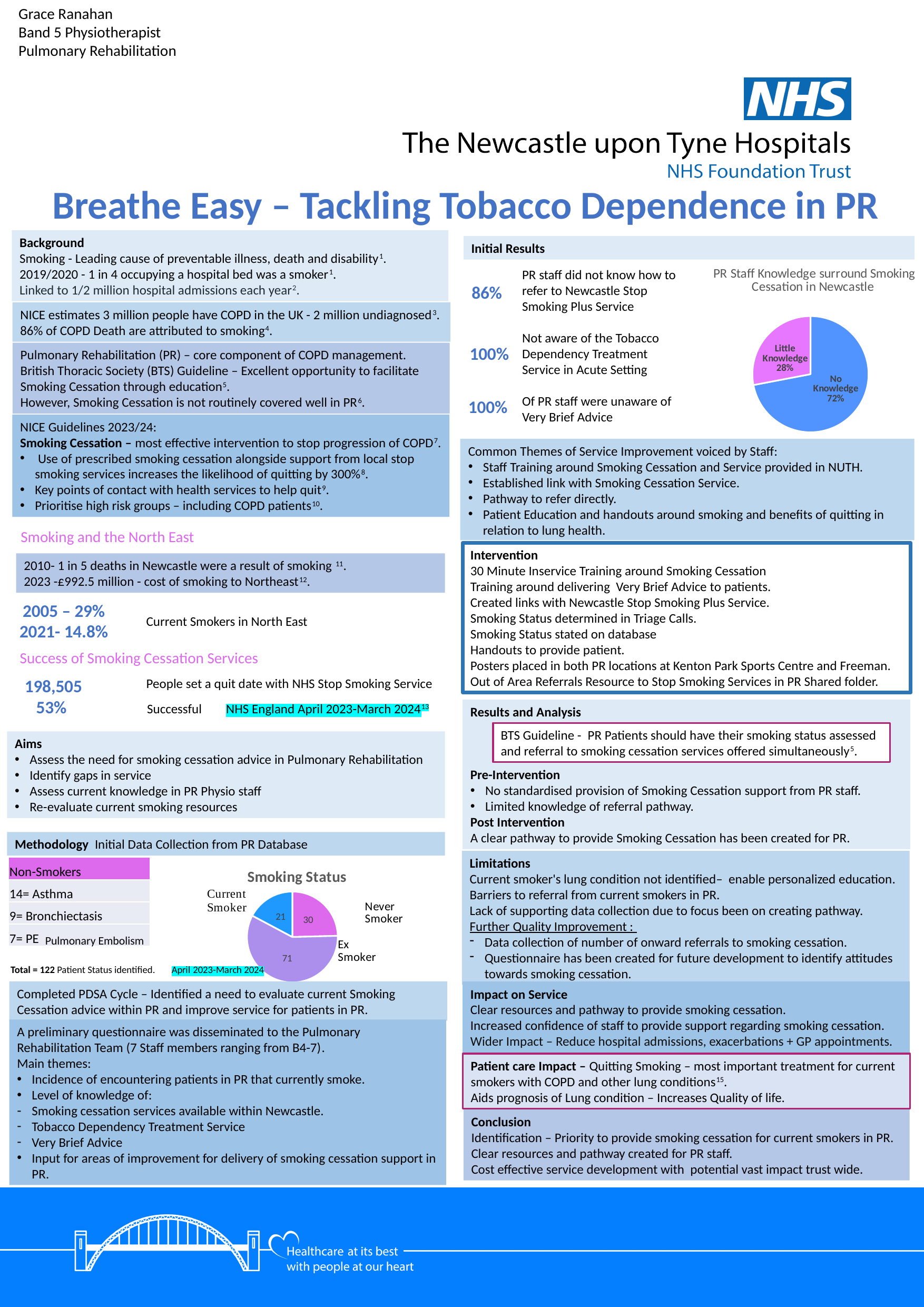
In the 'PR Staff Knowledge surround Smoking Cessation in Newcastle' chart, what is the difference in percentage points between No Knowledge and Little Knowledge? 44 In the 'PR Staff Knowledge surround Smoking Cessation in Newcastle' chart, what percentage of staff had No Knowledge? 72% In the 'Smoking Status' chart, what is the value for Never Smoker? 30 In the 'Smoking Status' chart, what is the total of all three slices? 122 In the 'Smoking Status' chart, what is the value for Ex Smoker? 71 In the 'Smoking Status' chart, is the value for Never Smoker larger or smaller than the value for Current Smoker? Larger What kind of chart is the 'PR Staff Knowledge surround Smoking Cessation in Newcastle' chart? Pie chart In the 'Smoking Status' chart, what is the value for Current Smoker? 21 How many slices does the 'PR Staff Knowledge surround Smoking Cessation in Newcastle' pie chart have? 2 In the 'PR Staff Knowledge surround Smoking Cessation in Newcastle' chart, which category is the largest? No Knowledge In the 'Smoking Status' chart, which category has the smallest value? Current Smoker In the 'PR Staff Knowledge surround Smoking Cessation in Newcastle' chart, what percentage of staff had Little Knowledge? 28%